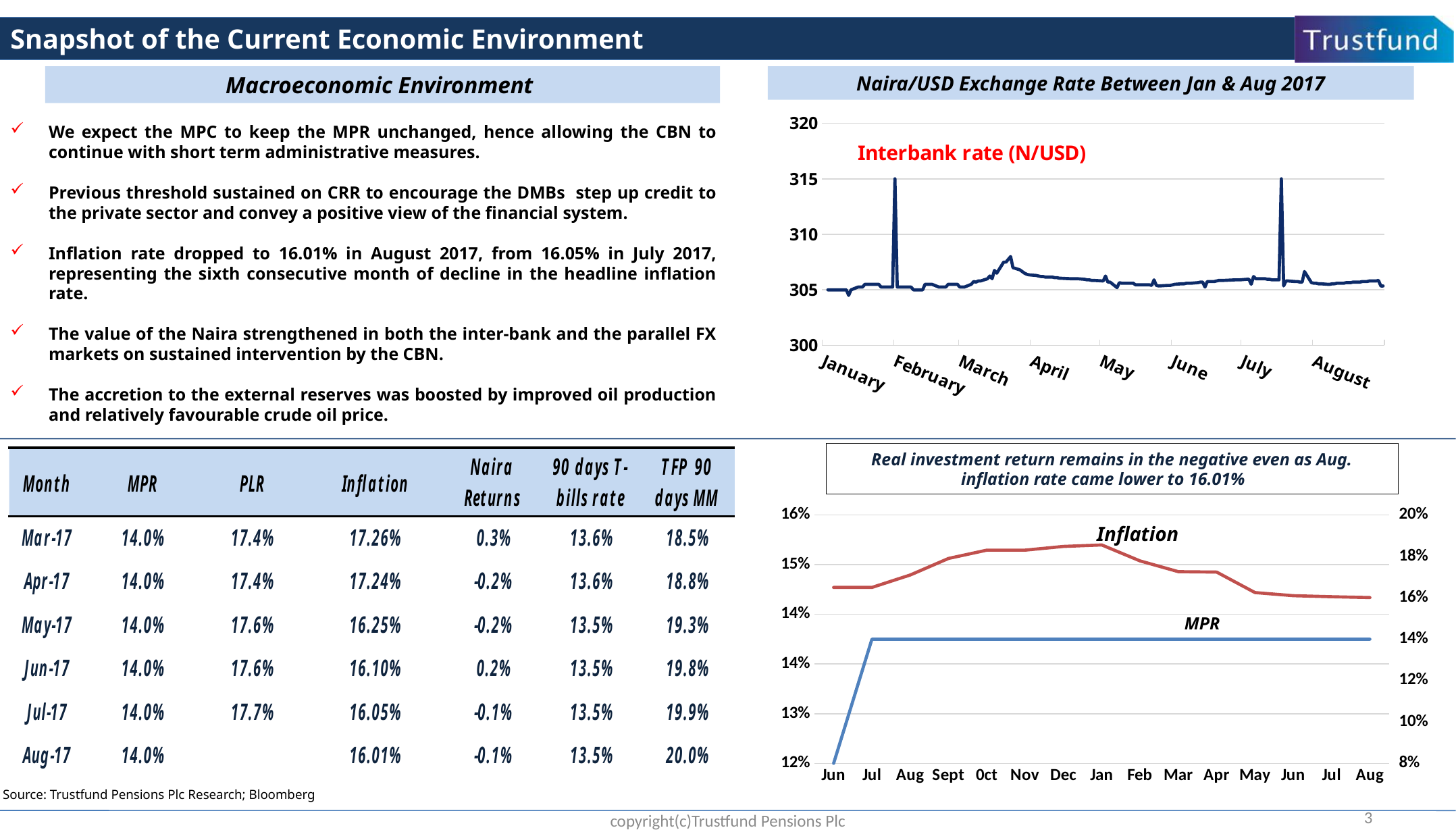
In the bottom-right chart, in which month does the Inflation line reach its highest point? Jan In the bottom-right chart, how many months are labelled on the x axis? 15 In the bottom-right chart, is the Inflation value in Jan greater or less than 18% on the right-hand axis? greater What kind of chart is the bottom-right chart titled 'Real investment return remains in the negative even as Aug. inflation rate came lower to 16.01%'? line chart In the 'Naira/USD Exchange Rate Between Jan & Aug 2017' chart, is the interbank rate at the start of January greater or less than 310? less In the 'Naira/USD Exchange Rate Between Jan & Aug 2017' chart, is the highest spike in the interbank rate greater or less than 310? greater What kind of chart is the 'Naira/USD Exchange Rate Between Jan & Aug 2017' chart? line chart In the bottom-right chart, how many series are plotted? 2 In the 'Naira/USD Exchange Rate Between Jan & Aug 2017' chart, what series name is printed on the chart? Interbank rate (N/USD) In the bottom-right chart, which series is higher in Aug, Inflation or MPR? Inflation In the bottom-right chart, does the Inflation line rise or fall from Jan to Aug? fall In the 'Naira/USD Exchange Rate Between Jan & Aug 2017' chart, how many months are labelled on the x axis? 8